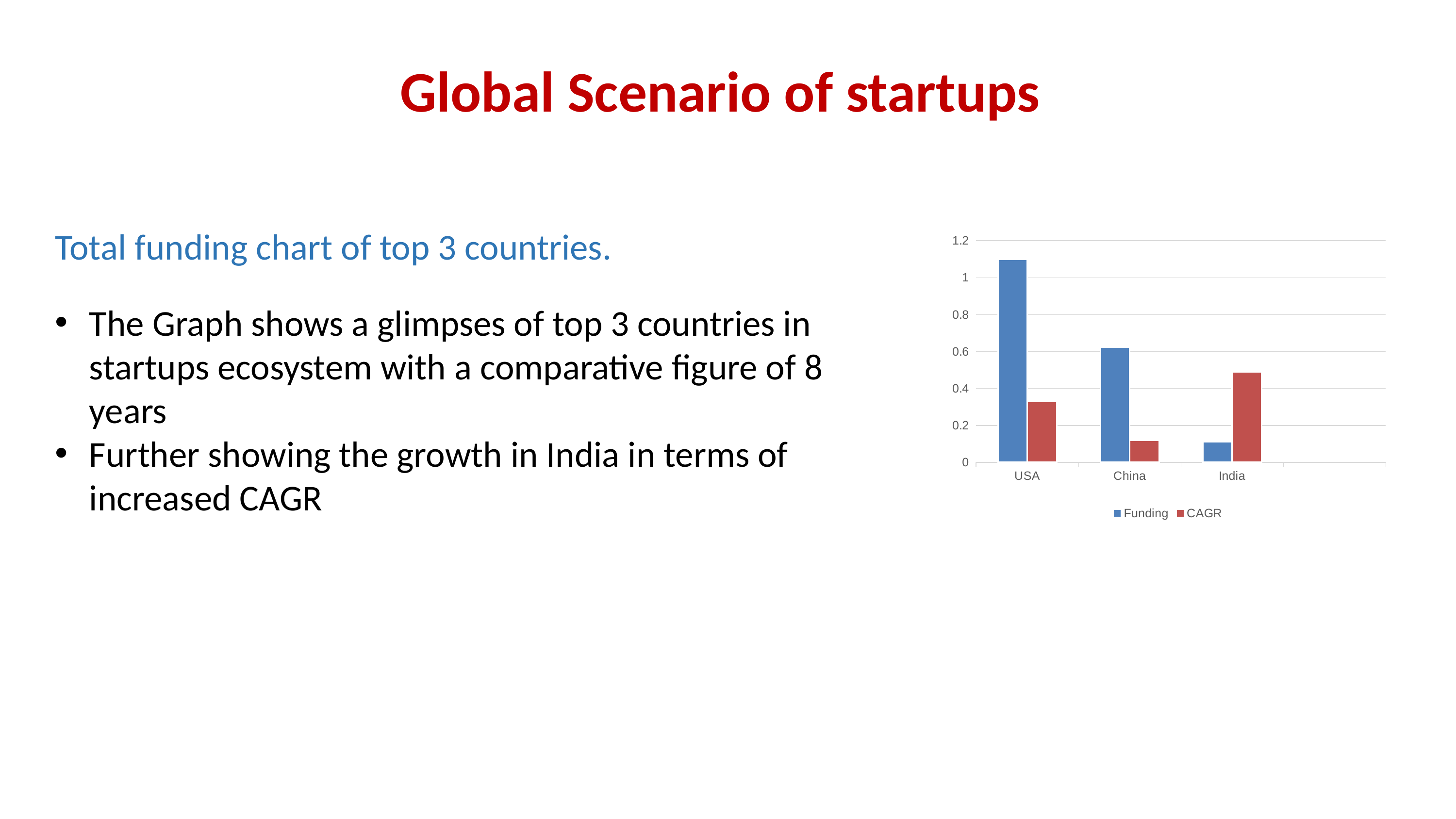
Which country has the highest Funding value in the chart? USA Which is larger for India: the Funding bar or the CAGR bar? CAGR Is the Funding value for USA greater or less than 1? greater How many countries are shown on the x axis of the chart? 3 Do the Funding values rise or fall going from USA to India along the x axis? fall Is the CAGR value for India greater or less than 0.4? greater Is the Funding value for India greater or less than 0.2? less Which country has the lowest CAGR value in the chart? China What kind of chart is shown on the slide? bar chart How many series does the chart's legend list? 2 Which country has the highest CAGR value in the chart? India Which country has the lowest Funding value in the chart? India